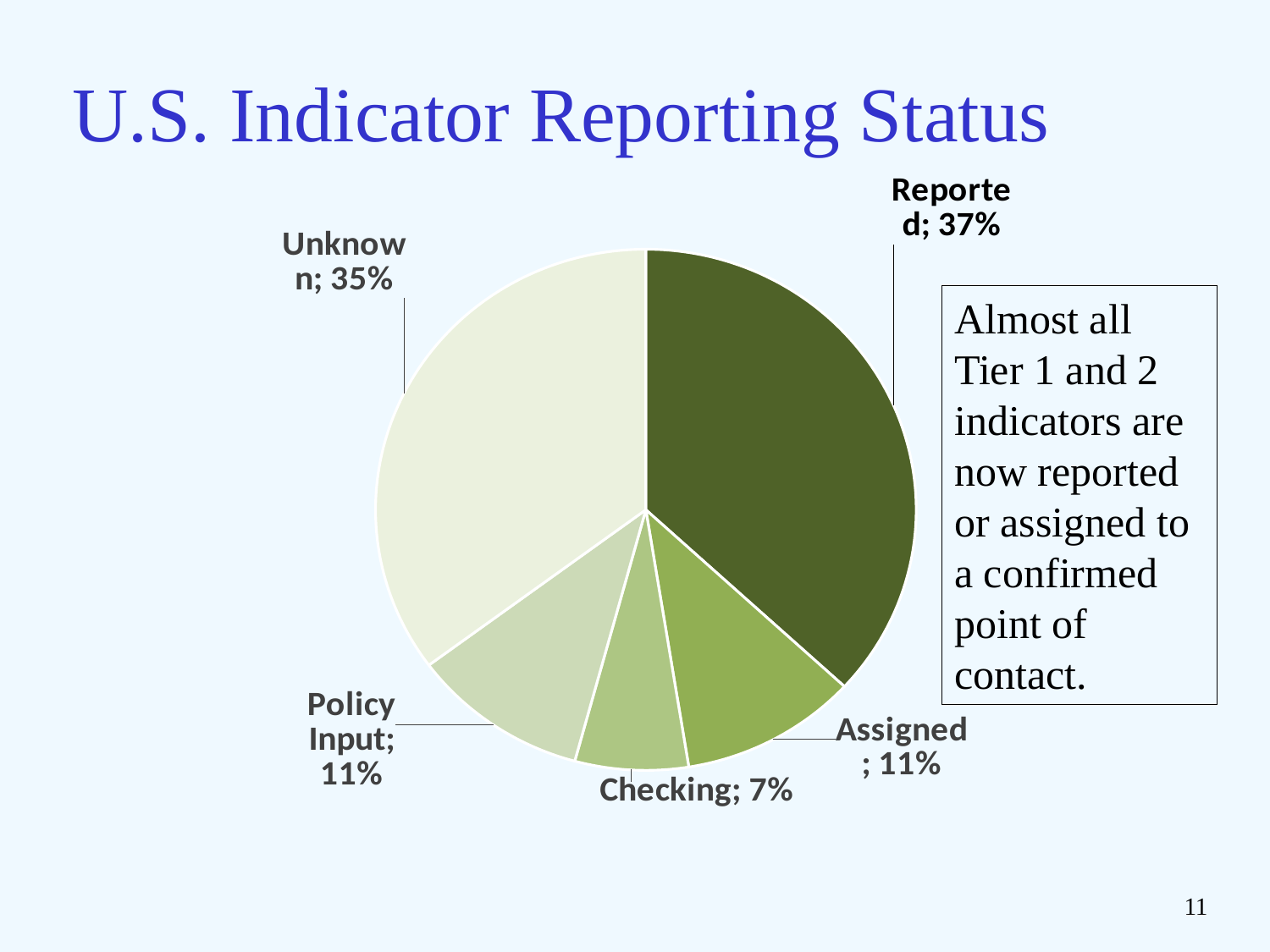
What share of the pie is labelled Reported? 37% Which slice of the pie is the largest? Reported What kind of chart is shown on the slide? pie chart What share of the pie is labelled Assigned? 11% Which is larger, the Unknown slice or the Checking slice? Unknown What is the title of the slide containing the pie chart? U.S. Indicator Reporting Status What share of the pie is labelled Checking? 7% Which slice of the pie is the smallest? Checking How many slices does the pie chart have? 5 What share of the pie is labelled Unknown? 35% What is the difference in percentage points between the Reported and Unknown slices? 2 What share of the pie is labelled Policy Input? 11%